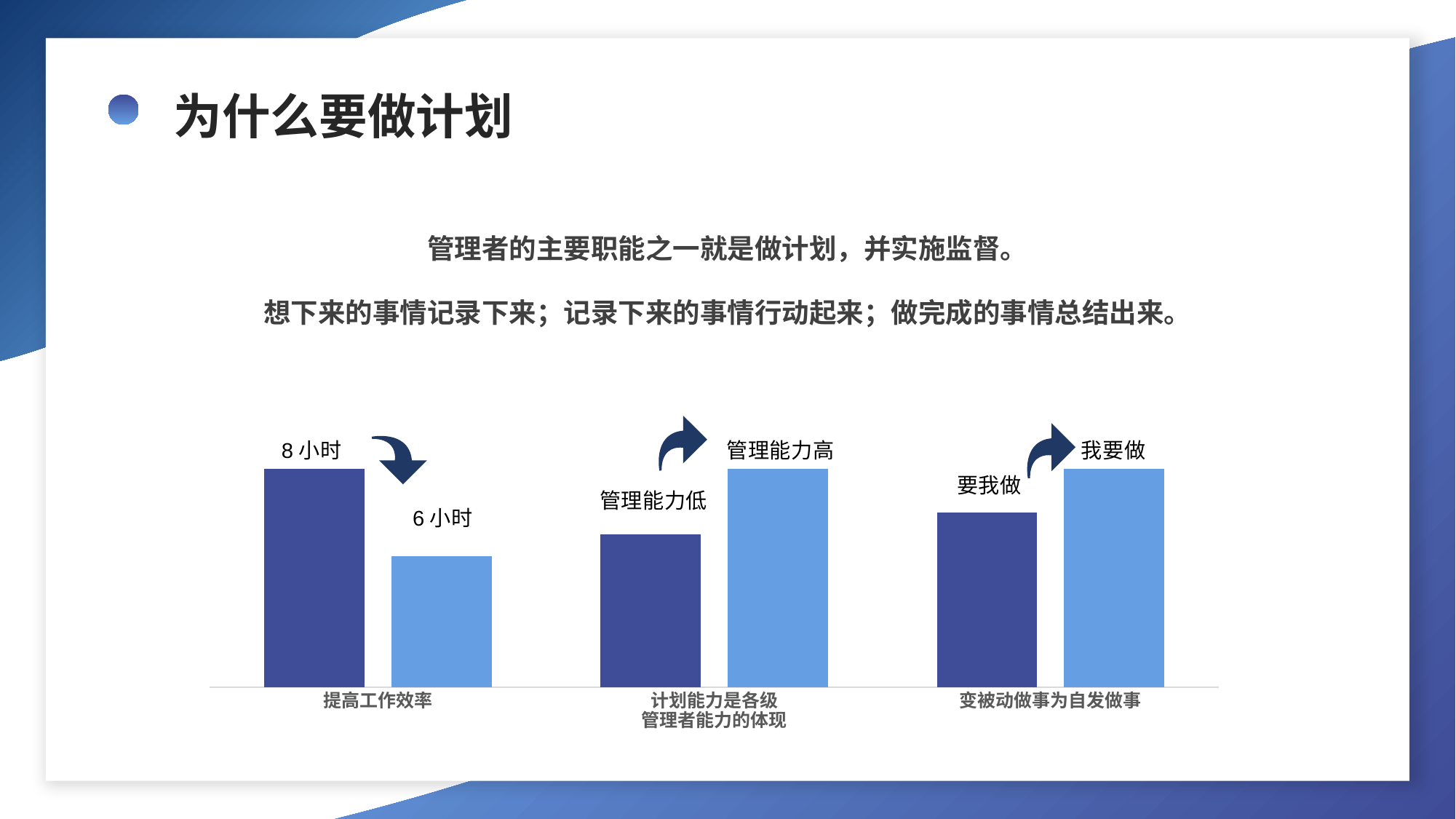
What is the difference between the two bars in the 提高工作效率 category? 2 小时 What is the data label on the light blue bar in the 提高工作效率 category? 6 小时 What is the data label on the dark blue bar in the 提高工作效率 category? 8 小时 In the 计划能力是各级管理者能力的体现 category, which bar is taller, 管理能力低 or 管理能力高? 管理能力高 In the 提高工作效率 category, which bar is taller, the 8 小时 bar or the 6 小时 bar? 8 小时 What kind of chart is shown on the slide? bar chart How many categories are shown along the x axis of the chart? 3 What colour is the bar labelled 我要做? light blue What is the label of the middle category on the x axis? 计划能力是各级管理者能力的体现 How many bars are plotted in the chart in total? 6 In the 变被动做事为自发做事 category, which bar is taller, 要我做 or 我要做? 我要做 Which bar in the whole chart is the shortest? 6 小时